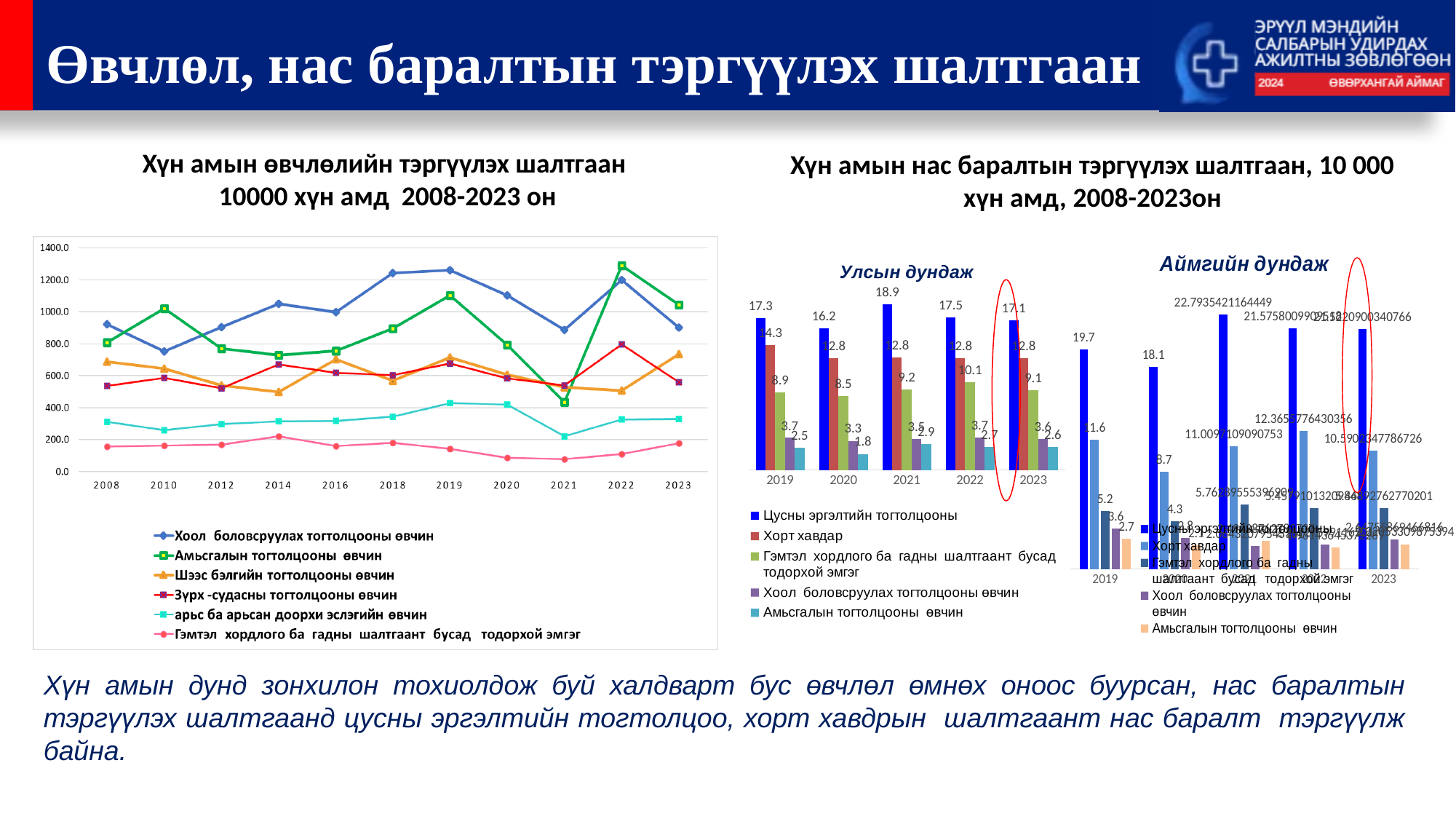
In the left line chart, how many series does the legend list? 6 In the 'Аймгийн дундаж' bar chart, what is the value for 'Цусны эргэлтийн тогтолцооны' in 2019? 19.7 In the 'Улсын дундаж' bar chart, which year has the highest value for 'Цусны эргэлтийн тогтолцооны'? 2021 In the left line chart, is the value for 'Гэмтэл хордлого ба гадны шалтгаант бусад тодорхой эмгэг' in 2021 greater or less than 200? less In the left line chart, is the value for 'Хоол боловсруулах тогтолцооны өвчин' in 2019 greater or less than 1200? greater In the 'Аймгийн дундаж' bar chart, what is the value for 'Хорт хавдар' in 2020? 8.7 In the 'Улсын дундаж' bar chart, which is larger in 2022: 'Гэмтэл хордлого ба гадны шалтгаант бусад тодорхой эмгэг' or 'Хоол боловсруулах тогтолцооны өвчин'? Гэмтэл хордлого ба гадны шалтгаант бусад тодорхой эмгэг In the 'Улсын дундаж' bar chart, what is the value for 'Цусны эргэлтийн тогтолцооны' in 2021? 18.9 In the 'Улсын дундаж' bar chart, what is the value for 'Хорт хавдар' in 2019? 14.3 In the left line chart, how many years are shown on the x axis? 11 What kind of chart is the left chart titled 'Хүн амын өвчлөлийн тэргүүлэх шалтгаан 10000 хүн амд 2008-2023 он'? line chart In the 'Улсын дундаж' bar chart, what is the difference between the 'Цусны эргэлтийн тогтолцооны' value and the 'Хорт хавдар' value in 2023? 4.3